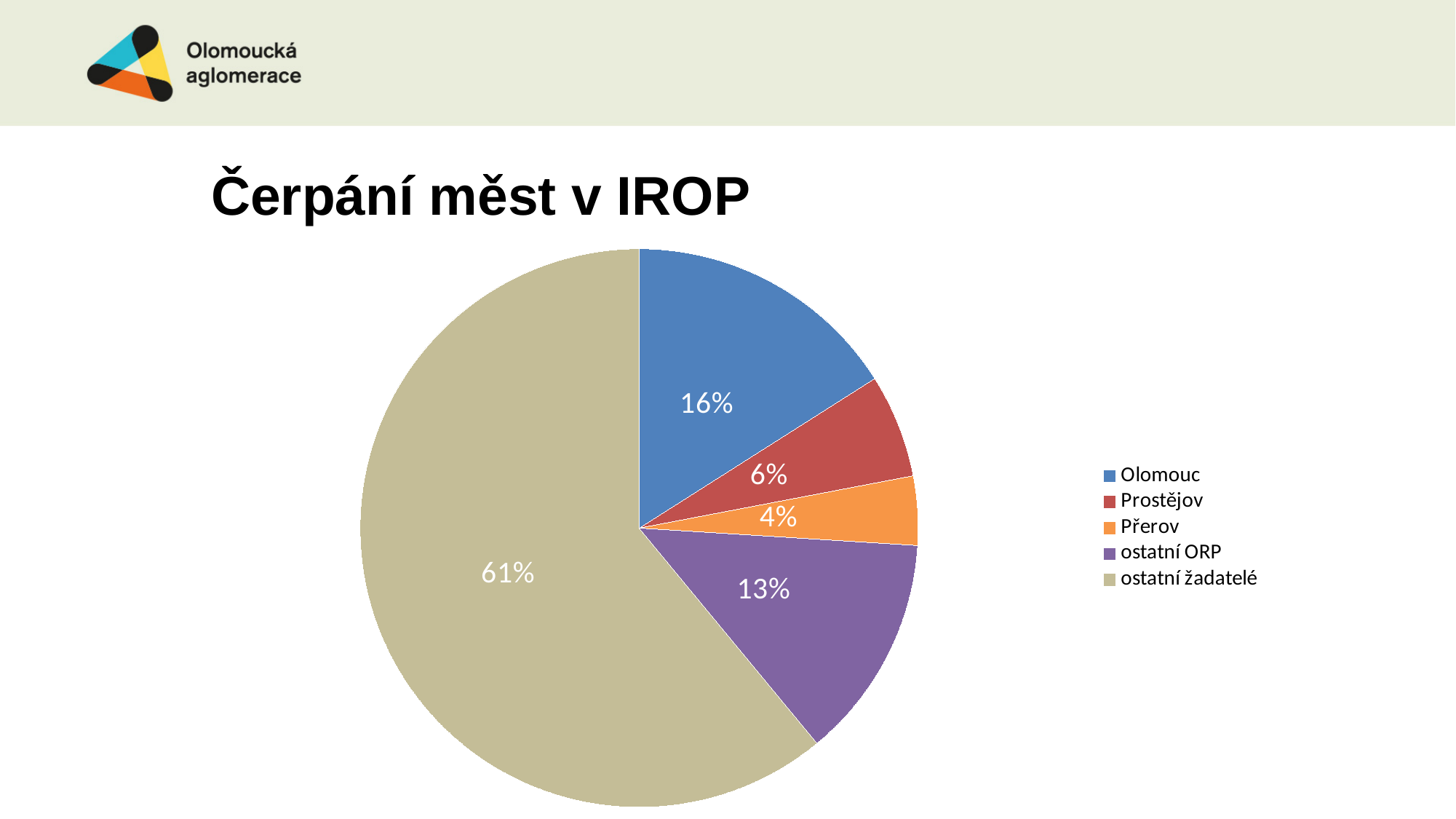
What share of the pie does Přerov have? 4% Which is larger, the slice for Prostějov or the slice for Přerov? Prostějov What share of the pie does ostatní žadatelé have? 61% What is the difference in percentage points between Olomouc and ostatní ORP? 3 Which category has the smallest slice of the pie? Přerov What share of the pie does ostatní ORP have? 13% What share of the pie does Prostějov have? 6% Which category has the largest slice of the pie? ostatní žadatelé What kind of chart is shown on the slide? pie chart What share of the pie does Olomouc have? 16% How many categories does the pie chart show? 5 What is the title of the slide containing the chart? Čerpání měst v IROP